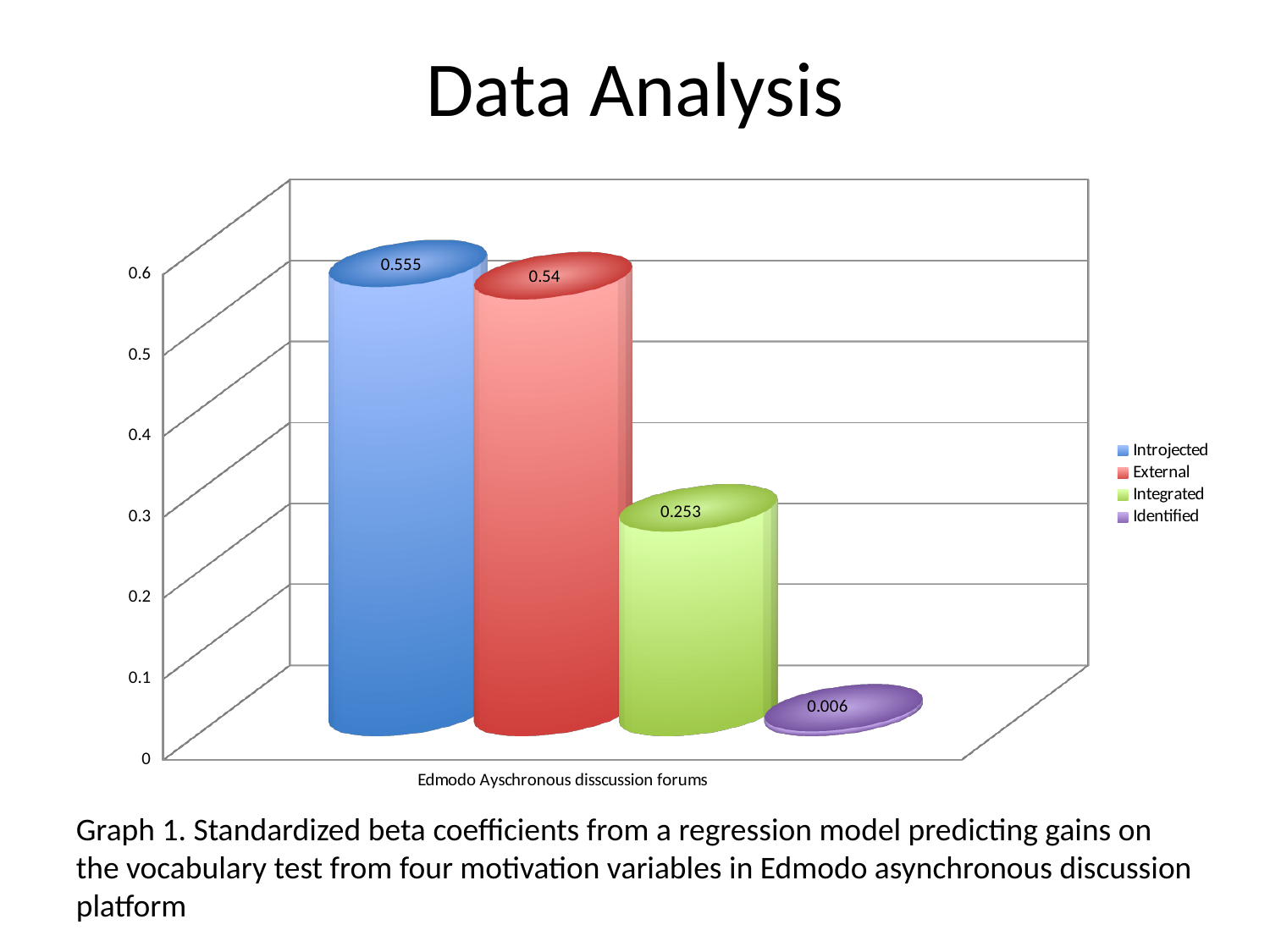
How many series does the legend list? 4 What is the difference between the values for External and Identified? 0.534 What is the value for External? 0.54 What is the difference between the values for Introjected and Integrated? 0.302 What is the label shown below the x axis of the chart? Edmodo Ayschronous disscussion forums What is the value for Integrated? 0.253 What kind of chart is shown on the slide? bar chart What is the value for Introjected? 0.555 Which is larger, the value for External or the value for Integrated? External What is the value for Identified? 0.006 Is the value for Integrated greater or less than 0.3? less Which series has the lowest value? Identified